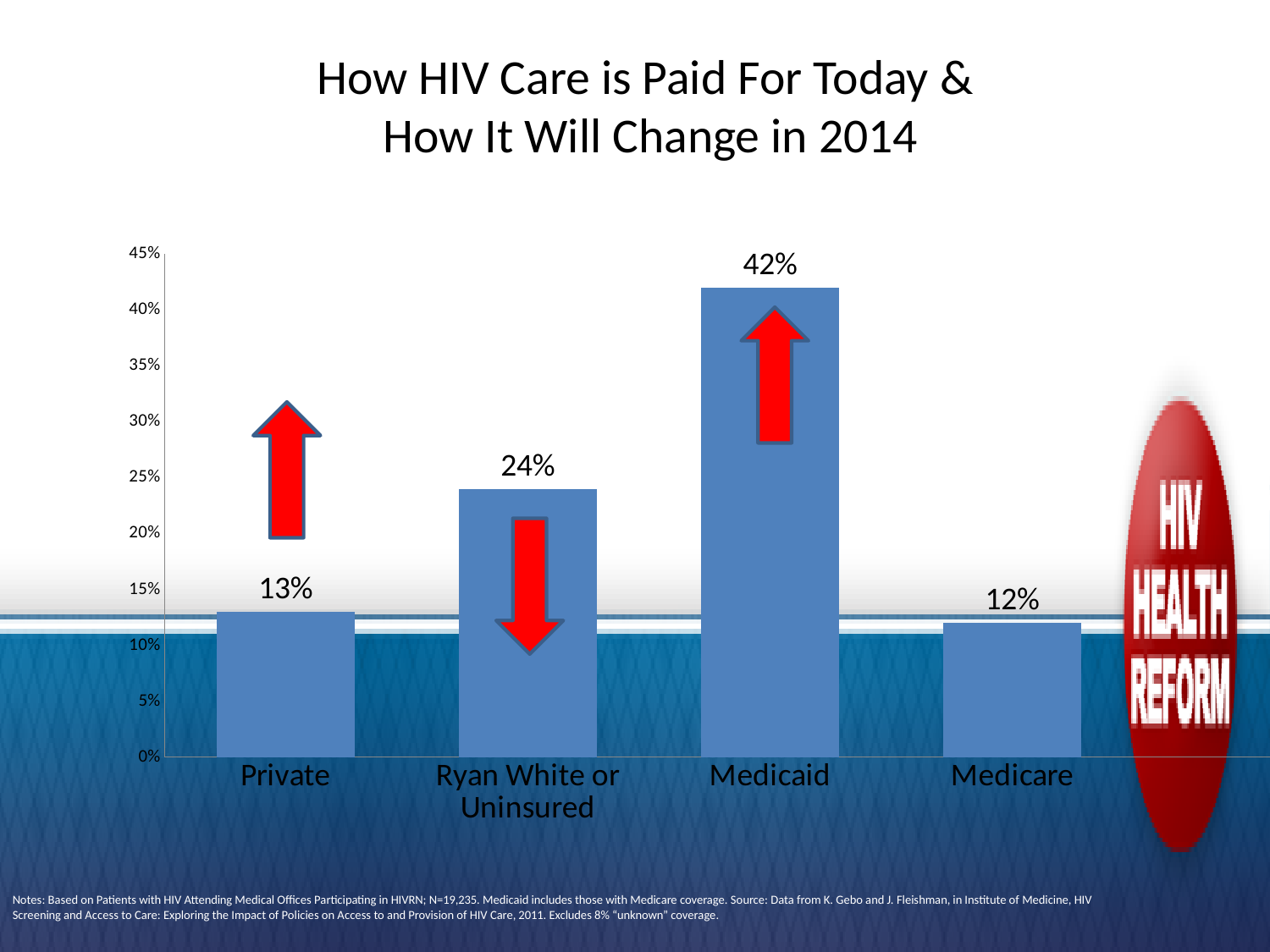
What is the value for Private? 13% Which category has the highest value? Medicaid What kind of chart is shown on the slide? Bar chart How many categories are shown on the x axis? 4 What is the value for Medicaid? 42% Which category has the lowest value? Medicare What is the difference between the values for Private and Medicare? 1% What is the value for Ryan White or Uninsured? 24% Which is larger, the value for Ryan White or Uninsured or the value for Private? Ryan White or Uninsured What is the difference between the values for Medicaid and Ryan White or Uninsured? 18% What is the value for Medicare? 12% Which categories have a red upward arrow on their bar? Private and Medicaid